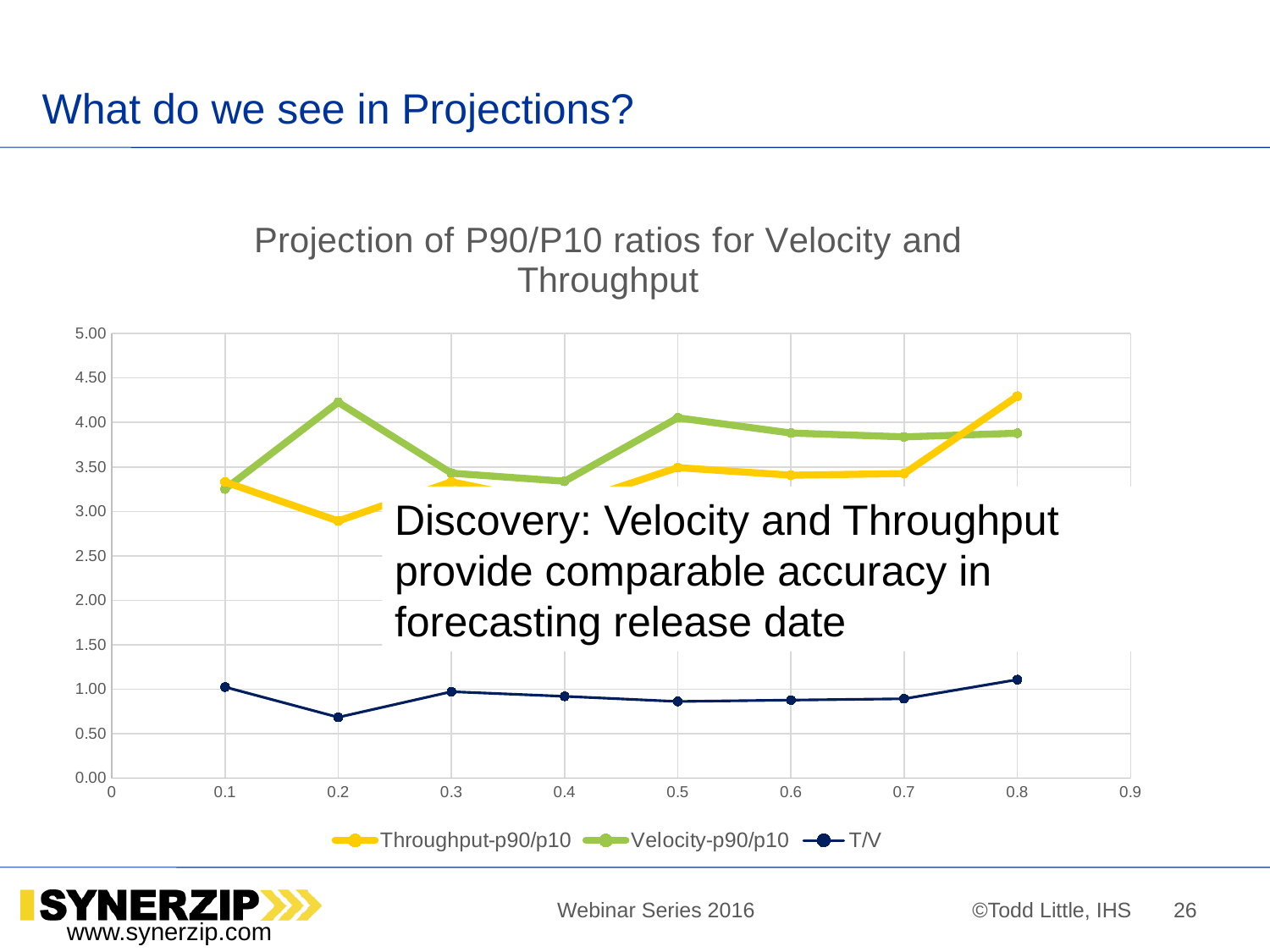
What is the title of the chart? Projection of P90/P10 ratios for Velocity and Throughput At x = 0.8, which series has the larger value, Throughput-p90/p10 or Velocity-p90/p10? Throughput-p90/p10 Is the value of Throughput-p90/p10 at x = 0.8 greater or less than 4.00? greater Is the value of Throughput-p90/p10 at x = 0.2 greater or less than 3.00? less How many series does the legend list? 3 Which series is drawn in dark blue according to the legend? T/V At which x value does the Throughput-p90/p10 series reach its lowest point? 0.2 How many data points are plotted for the T/V series? 8 What kind of chart is shown on the slide? Line chart Is the value of Velocity-p90/p10 at x = 0.2 greater or less than 4.00? greater At x = 0.2, which series has the larger value, Velocity-p90/p10 or Throughput-p90/p10? Velocity-p90/p10